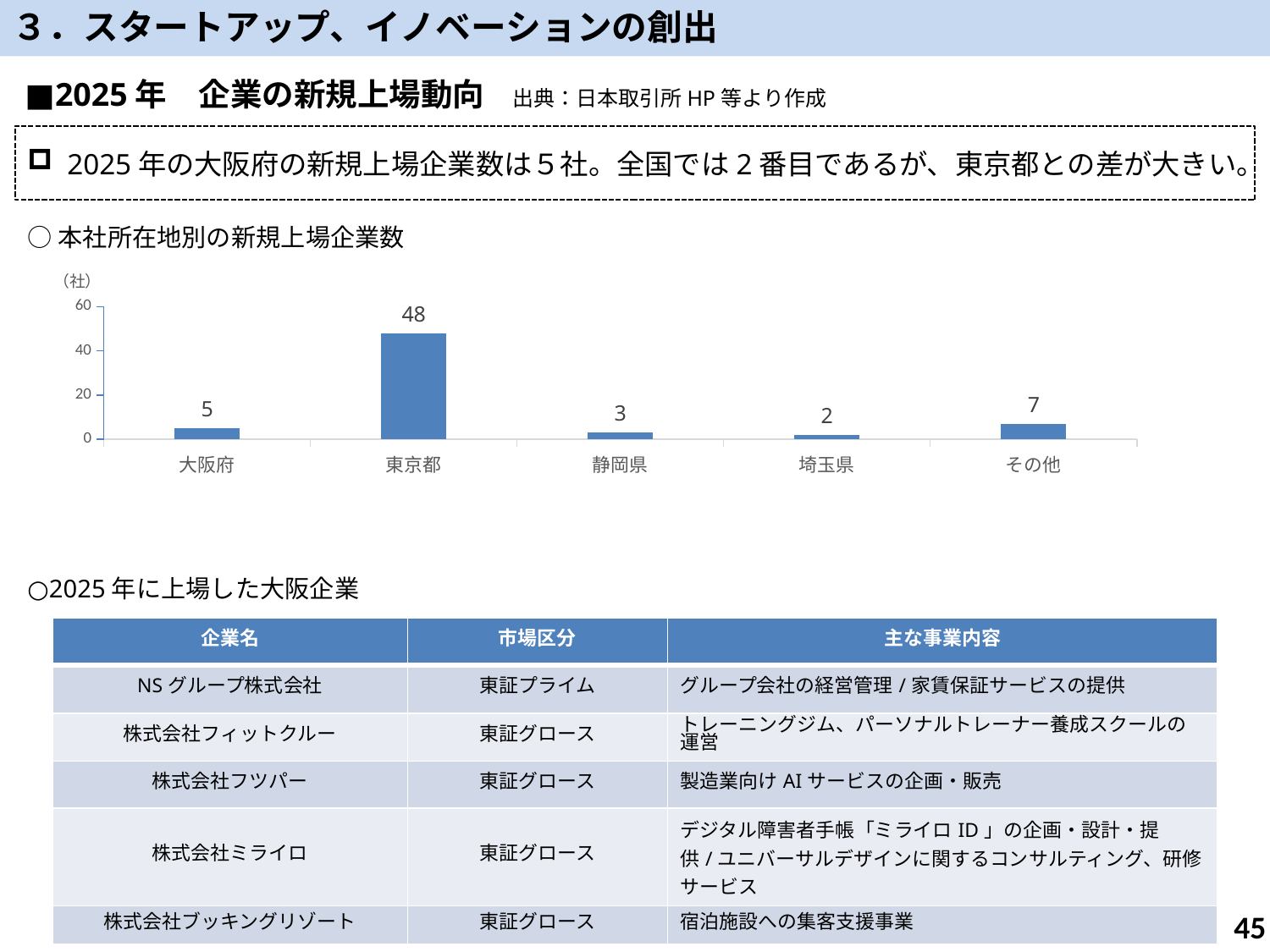
How many categories are shown on the x axis of the chart? 5 What kind of chart is used to show the number of newly listed companies by headquarters location? bar chart What is the number of newly listed companies for 東京都? 48 What is the value shown for 静岡県? 3 Which is larger, the value for 大阪府 or the value for その他? その他 What is the difference between the values for 東京都 and 大阪府? 43 Which category has the highest number of newly listed companies? 東京都 What is the number of newly listed companies for 大阪府? 5 What is the value shown for 埼玉県? 2 Is the value for 東京都 greater or less than 40? greater Which category has the lowest number of newly listed companies? 埼玉県 What is the value shown for その他? 7